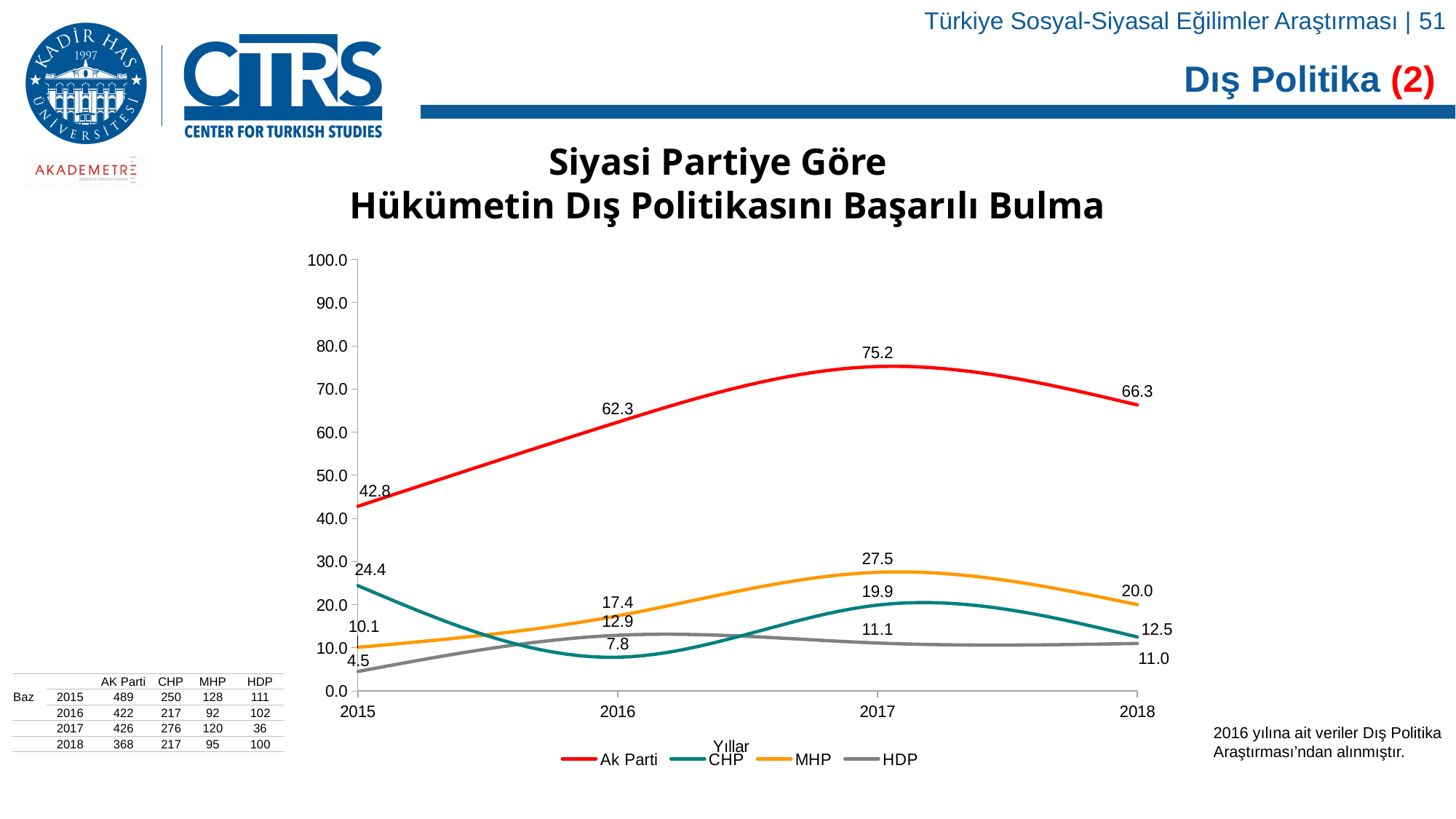
What is the value for MHP in 2018? 20.0 What is the value for HDP in 2015? 4.5 How many years are plotted on the x axis? 4 What is the value for CHP in 2016? 7.8 What is the value for Ak Parti in 2017? 75.2 What type of chart is shown on the slide? line chart How many series does the legend list? 4 In which year does Ak Parti reach its highest value? 2017 Does the MHP line rise or fall from 2015 to 2017? rise In which year does CHP have its lowest value? 2016 What is the difference between the Ak Parti values in 2017 and 2018? 8.9 Which is larger in 2018, the value for CHP or the value for HDP? CHP